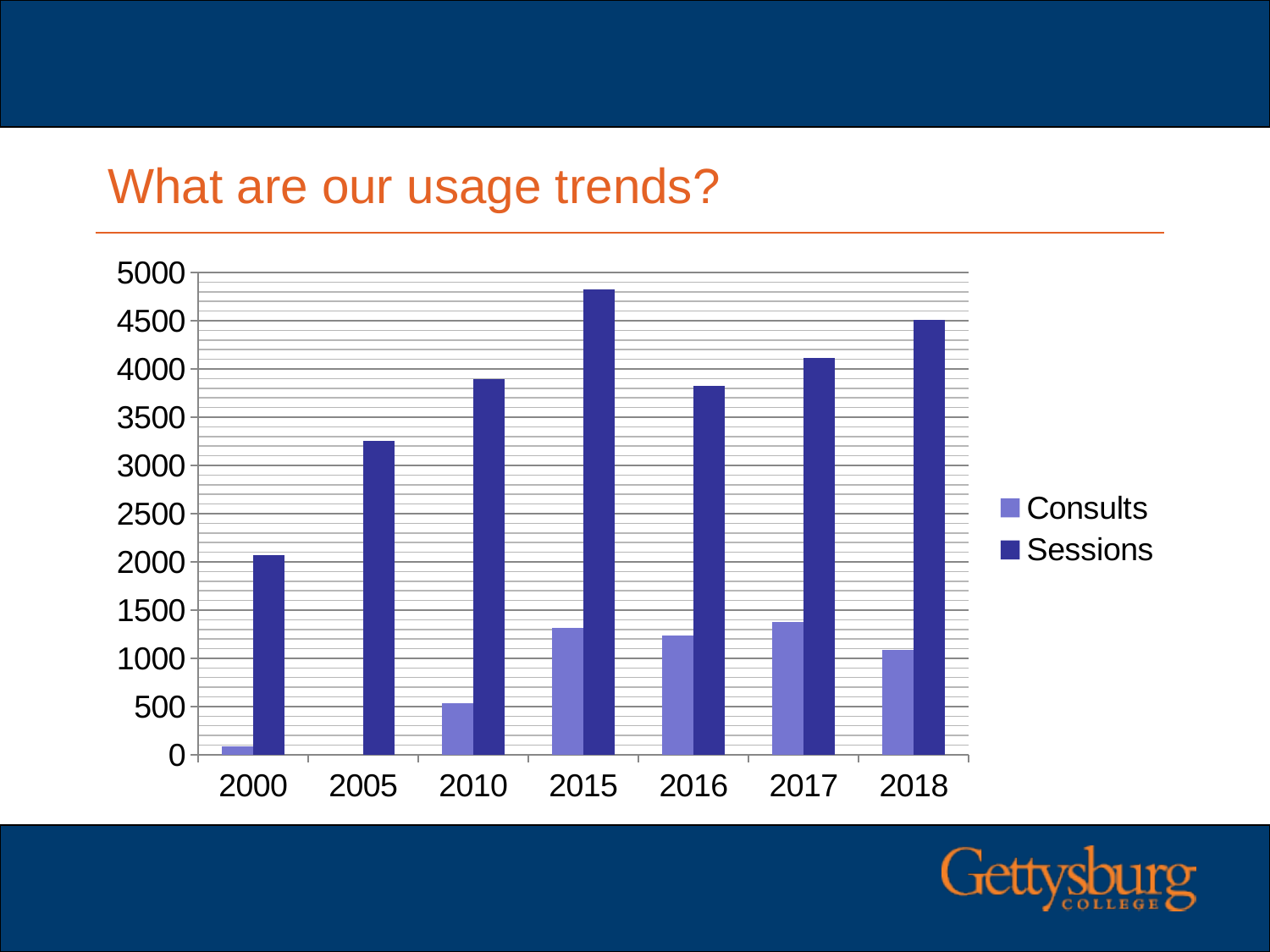
Which year has the highest value for Sessions? 2015 Is the value for Sessions in 2018 greater or less than 4000? greater How many years are shown on the x axis? 7 Which year has the lowest value for Sessions? 2000 How many series does the legend list? 2 Which is larger, Sessions in 2017 or Sessions in 2016? Sessions in 2017 Which is larger, Consults in 2015 or Consults in 2010? Consults in 2015 Is the value for Sessions in 2005 greater or less than 3000? greater What is the title of the slide containing the chart? What are our usage trends? Is the value for Consults in 2010 greater or less than 1000? less What kind of chart is shown on the slide? bar chart